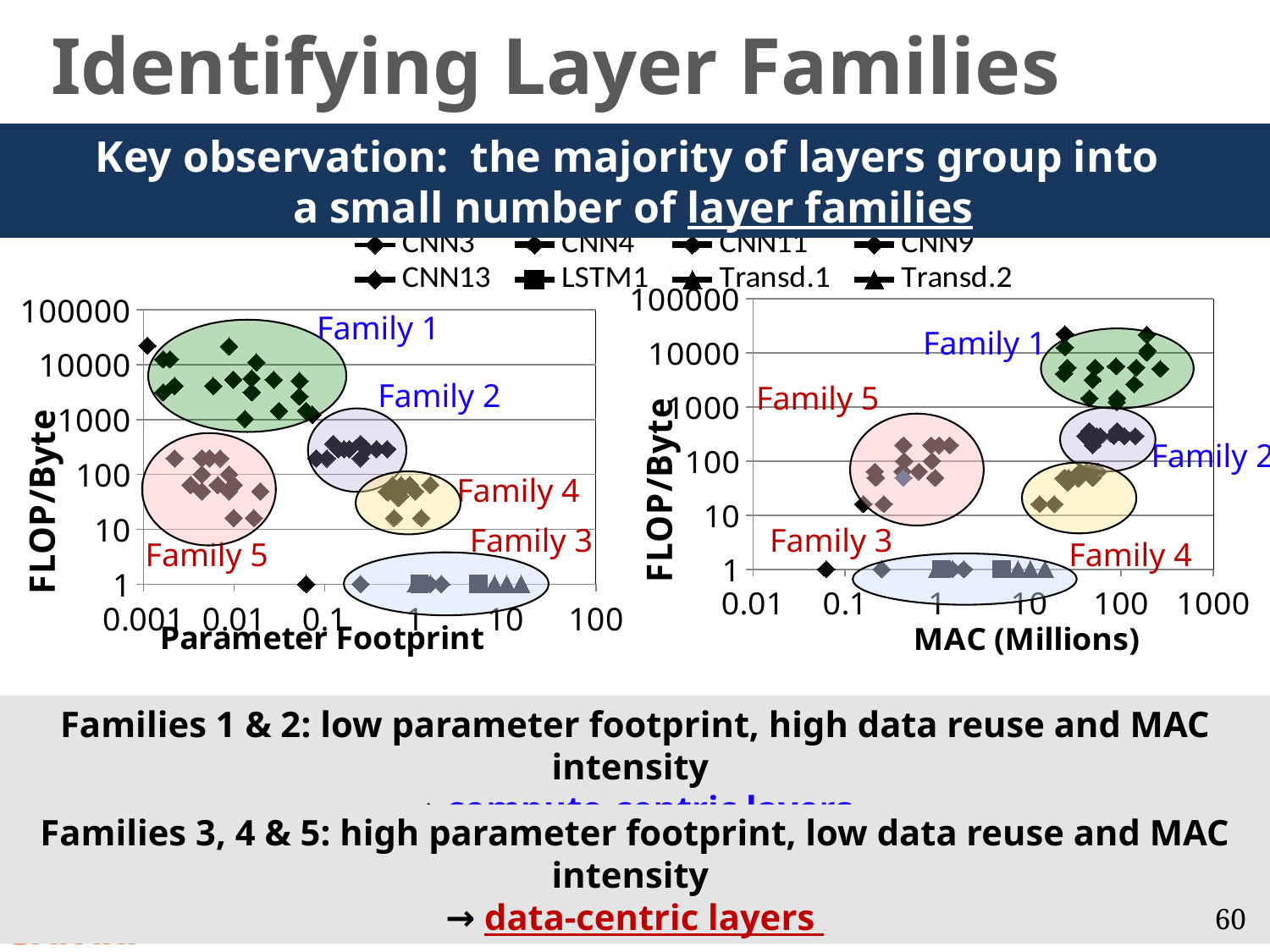
On the right chart (MAC (Millions)), are the FLOP/Byte values of the Family 2 points greater or less than 100? greater On the right chart (MAC (Millions)), are the FLOP/Byte values of the Family 1 points greater or less than 1000? greater What kind of chart is the left chart with the x axis labelled Parameter Footprint? scatter chart On the right chart (MAC (Millions)), are the MAC values of the Family 1 points greater or less than 10? greater How many series does the legend above the charts list? 8 What is the x-axis label of the right chart? MAC (Millions) What is the y-axis label shared by both charts? FLOP/Byte